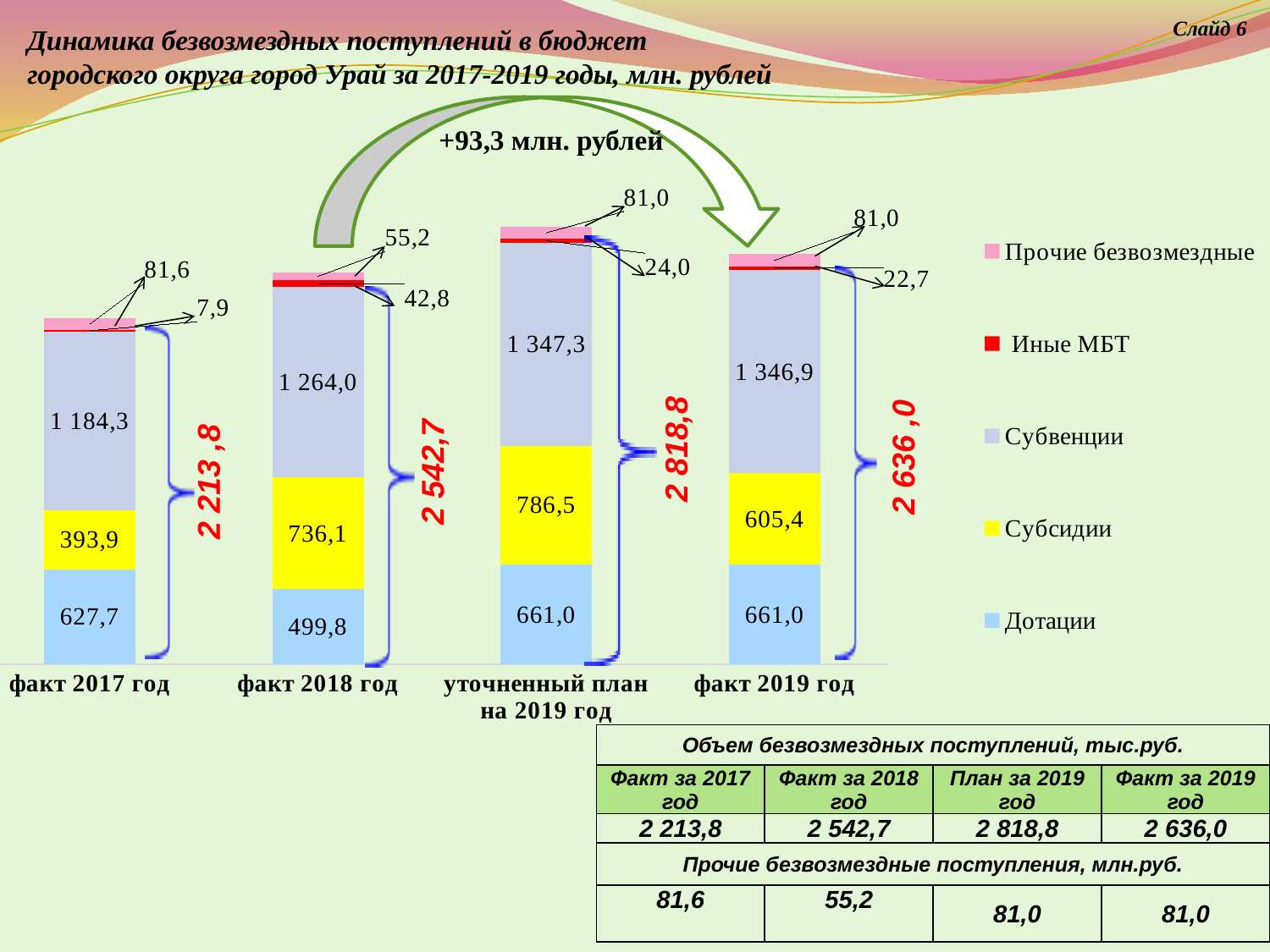
What is the total of the stacked bar for уточненный план на 2019 год? 2 818,8 What type of chart is shown on the slide? stacked bar chart How many series does the chart legend list? 5 Which category has the lowest stacked bar total? факт 2017 год What is the value of Дотации for факт 2019 год? 661,0 Which is larger: Дотации for факт 2017 год or Дотации for факт 2018 год? факт 2017 год What is the value of Субсидии for факт 2018 год? 736,1 Which category has the highest stacked bar total? уточненный план на 2019 год What is the value of Иные МБТ for уточненный план на 2019 год? 24,0 What is the value of Субвенции for факт 2017 год? 1 184,3 How many categories (bars) are shown on the x axis of the chart? 4 What is the difference between the Субсидии values for уточненный план на 2019 год and факт 2019 год? 181,1